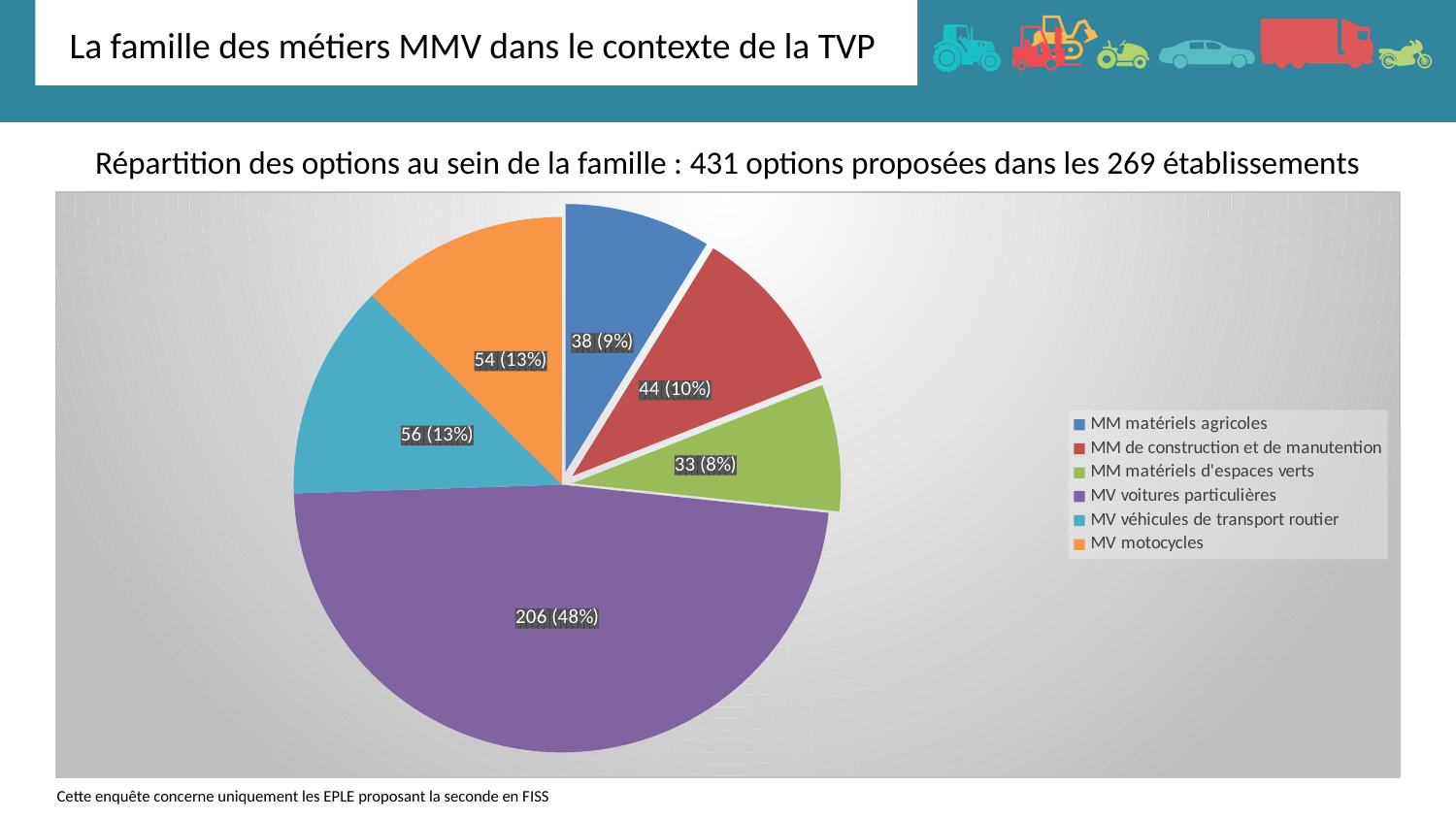
What type of chart is shown on the slide? pie chart What is the value shown for MV voitures particulières? 206 (48%) What is the value shown for MM de construction et de manutention? 44 (10%) Which is larger, the value for MM de construction et de manutention or the value for MM matériels d'espaces verts? MM de construction et de manutention What is the value shown for MM matériels agricoles? 38 (9%) What colour is the slice for MV motocycles? orange How many entries does the legend list? 6 Which category has the smallest slice of the pie? MM matériels d'espaces verts How many slices does the pie chart have? 6 What is the difference between the values for MV véhicules de transport routier and MV motocycles? 2 What share of the pie does MV véhicules de transport routier represent? 13% Which category has the largest slice of the pie? MV voitures particulières